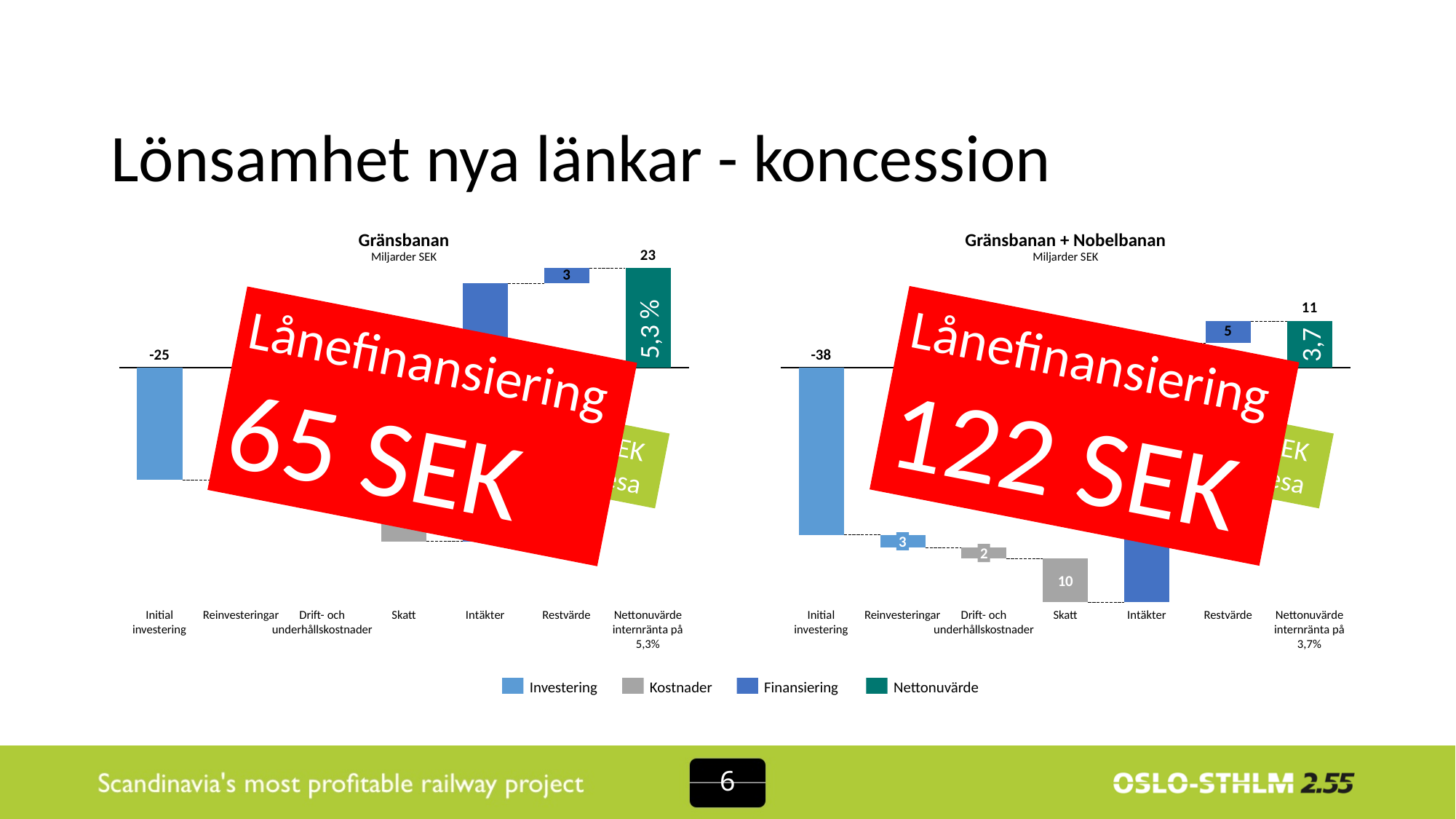
In the Gränsbanan + Nobelbanan chart, what is the value for Initial investering? -38 In the Gränsbanan chart, what is the value for Restvärde? 3 Which chart shows the larger Restvärde value, Gränsbanan or Gränsbanan + Nobelbanan? Gränsbanan + Nobelbanan In the Gränsbanan + Nobelbanan chart, what is the value for Restvärde? 5 In the Gränsbanan + Nobelbanan chart, what is the value for Skatt? 10 In the Gränsbanan chart, what is the value of the Nettonuvärde bar? 23 In the Gränsbanan chart, what is the value for Initial investering? -25 In the Gränsbanan + Nobelbanan chart, what is the value of the Nettonuvärde bar? 11 How many entries does the shared legend below the charts list? 4 What unit is stated under the title of the Gränsbanan chart? Miljarder SEK What is the difference between the Nettonuvärde in the Gränsbanan chart and the Nettonuvärde in the Gränsbanan + Nobelbanan chart? 12 How many categories are shown on the x axis of the Gränsbanan + Nobelbanan chart? 7